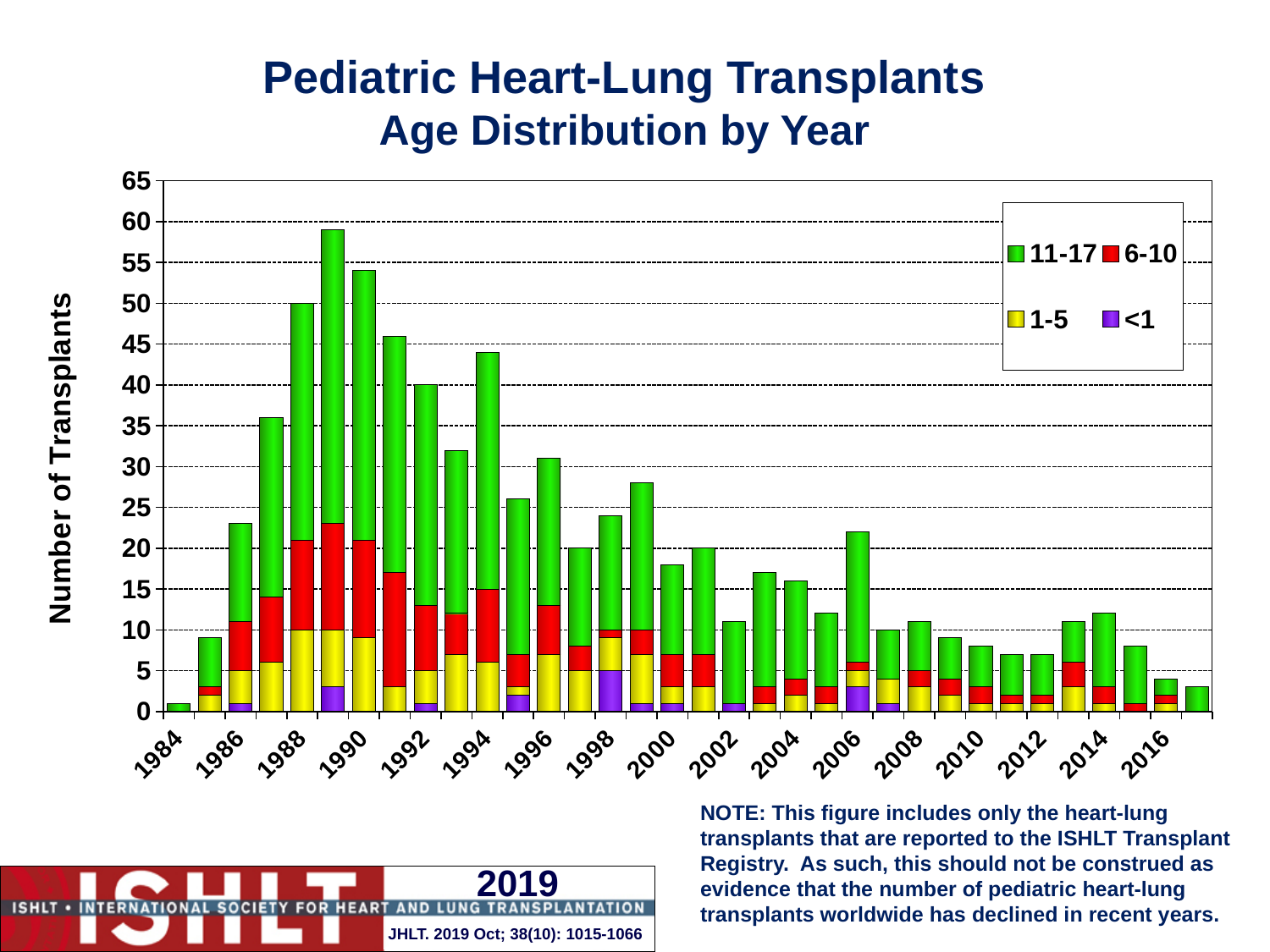
Which year has the lowest total number of transplants? 1984 Which age group is shown in green in the legend? 11-17 Which year has a higher total number of transplants, 1986 or 1987? 1987 Is the total number of transplants in 1989 greater or less than 55? greater What kind of chart is shown on the slide? stacked bar chart Do the total numbers of transplants generally rise or fall from 1989 to 2017? fall Is the total number of transplants in 2007 greater or less than 15? less How many series does the legend list? 4 Is the total number of transplants in 1992 greater or less than 45? less Which year has the highest total number of transplants? 1989